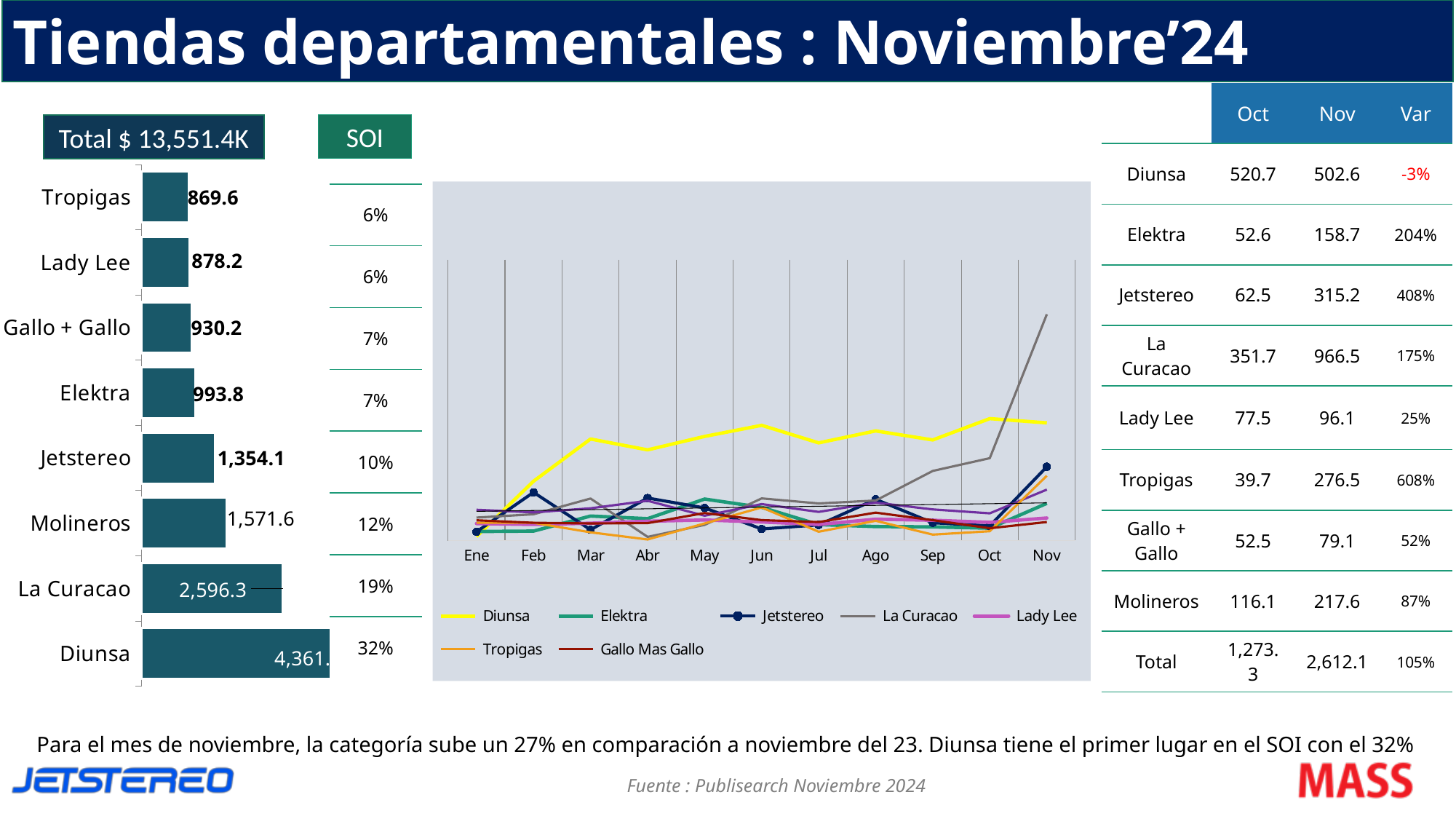
On the line chart, does the La Curacao line rise or fall from Sep to Nov? rise On the line chart, which series has the highest value in Nov? La Curacao How many series does the legend of the line chart list? 7 On the bar chart, what is the value for Elektra? 993.8 On the bar chart, which category has the lowest value? Tropigas On the bar chart, which category has the highest value? Diunsa What type of chart is the chart on the left of the slide? bar chart On the bar chart, what is the value for Jetstereo? 1,354.1 On the bar chart, what is the value for La Curacao? 2,596.3 On the bar chart, what is the difference between Molineros and Jetstereo? 217.5 On the bar chart, which is larger, Gallo + Gallo or Lady Lee? Gallo + Gallo How many categories does the bar chart show? 8